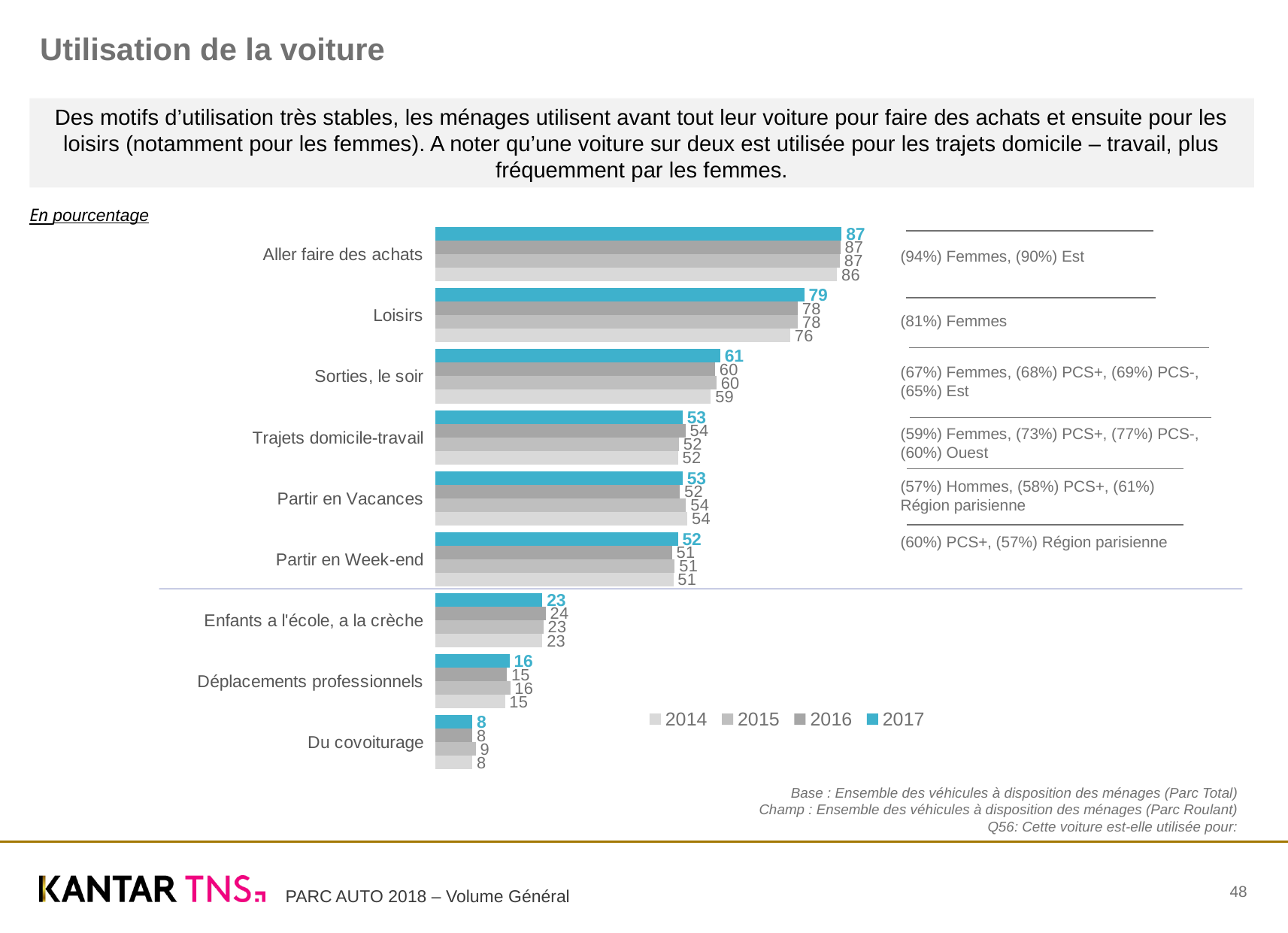
What kind of chart is shown on the slide? Bar chart Which category has the lowest 2017 value? Du covoiturage How many categories are shown in the chart? 9 What is the difference between the 2017 values for "Loisirs" and "Sorties, le soir"? 18 What is the 2015 value for "Partir en Vacances"? 54 Which category has the highest 2017 value? Aller faire des achats Which is larger: the 2017 value for "Enfants a l'école, a la crèche" or the 2017 value for "Déplacements professionnels"? Enfants a l'école, a la crèche Which year is represented by the blue bars in the chart? 2017 What is the 2016 value for "Du covoiturage"? 8 What is the 2017 value for "Aller faire des achats"? 87 How many series does the legend list? 4 What is the 2014 value for "Loisirs"? 76